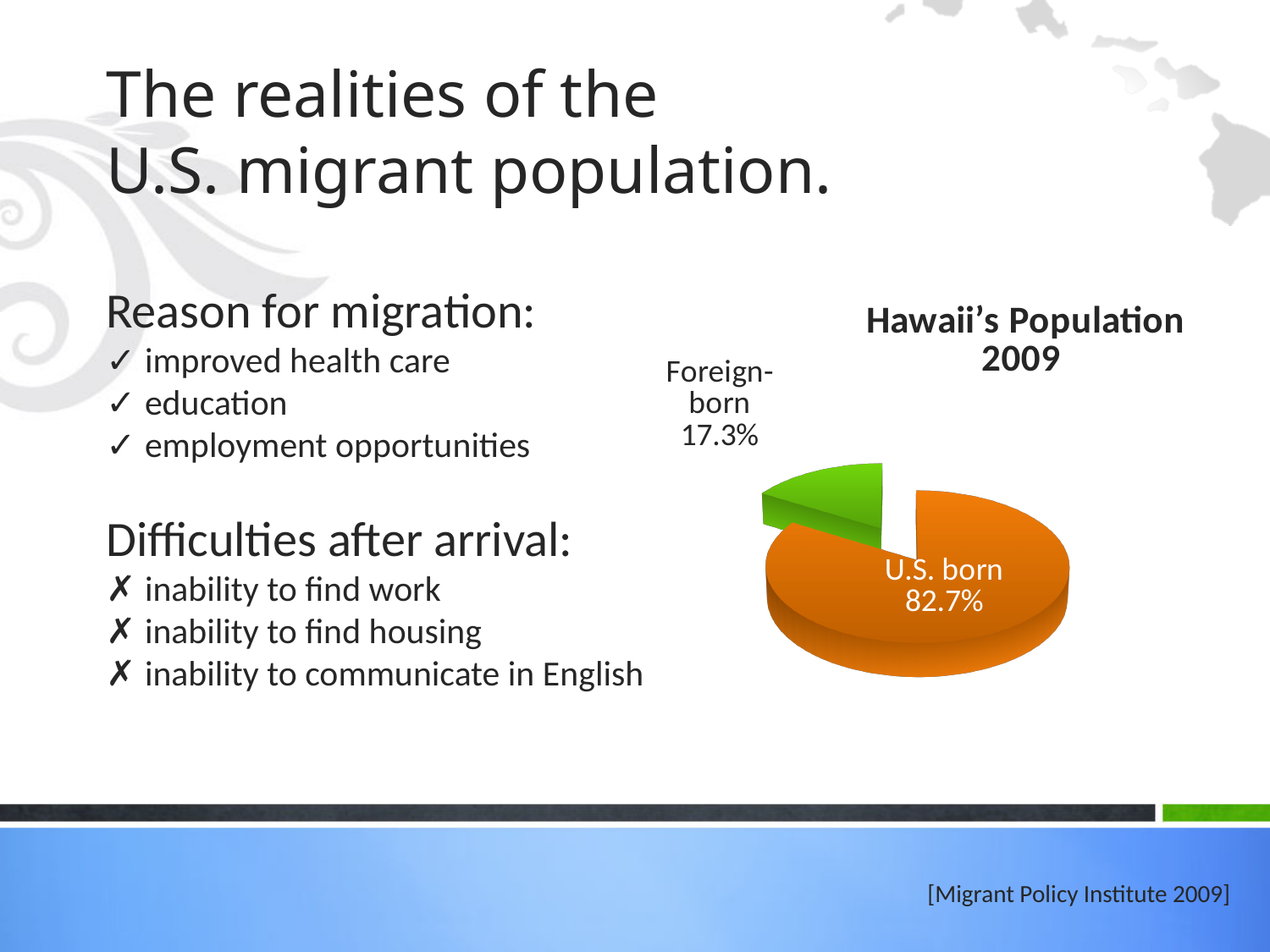
What kind of chart is shown on the slide? Pie chart Which slice of the pie is the largest? U.S. born What is the difference in percentage points between the U.S. born and foreign-born shares? 65.4 What share of Hawaii's population in 2009 is U.S. born? 82.7% Which slice of the pie is the smallest? Foreign-born How many slices does the pie chart have? 2 What colour is the foreign-born slice? Green What share of Hawaii's population in 2009 is foreign-born? 17.3% What is the title of the chart? Hawaii's Population 2009 What is the total of the two slices shown in the pie chart? 100% Which is larger, the U.S. born share or the foreign-born share? U.S. born